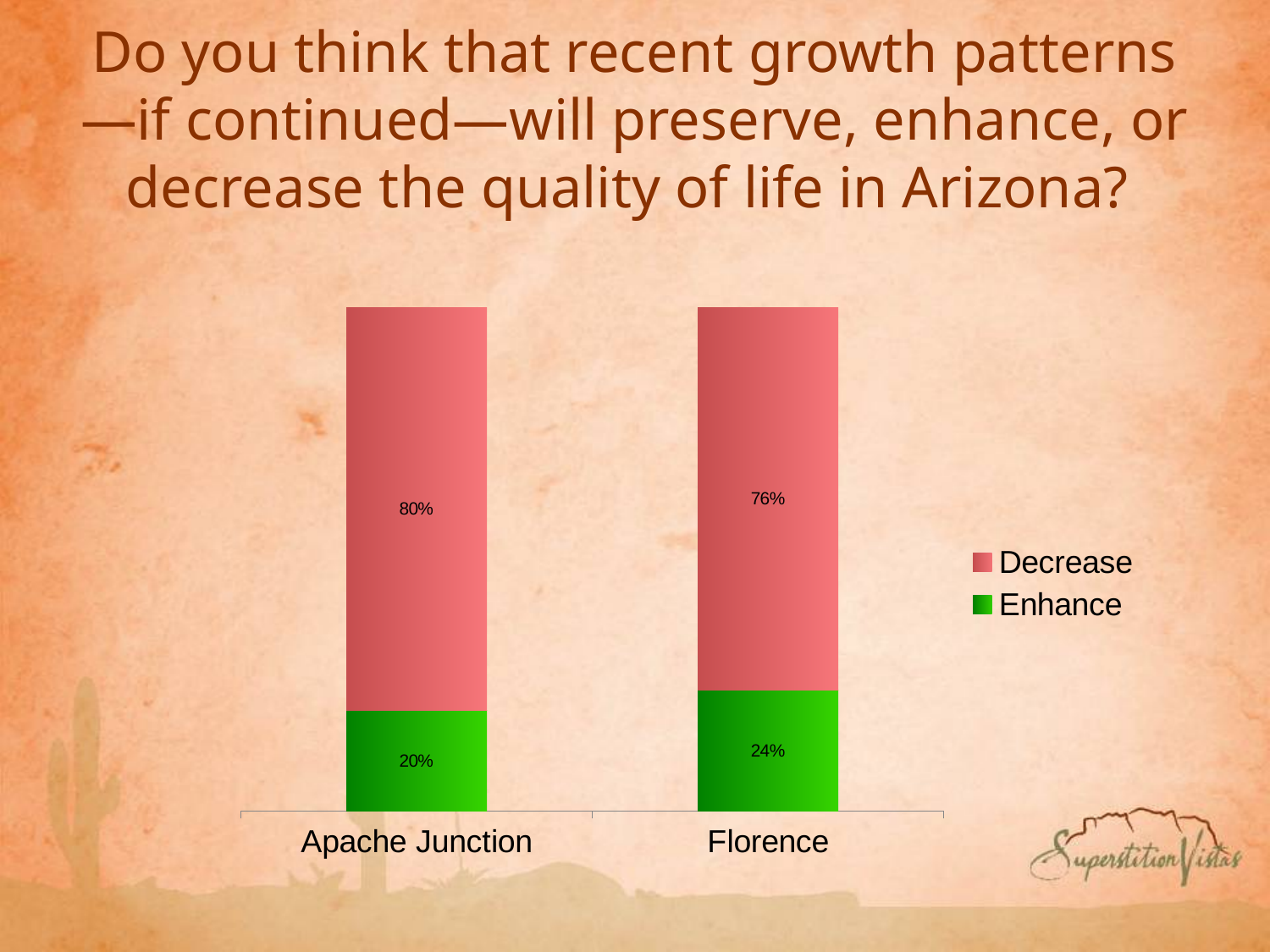
How many series does the legend list? 2 How many locations are shown on the x axis? 2 Is the Enhance value larger for Florence or Apache Junction? Florence What percentage of Apache Junction respondents said growth patterns will decrease quality of life? 80% Which location has the higher Decrease percentage? Apache Junction What is the difference between the Decrease values for Apache Junction and Florence? 4% What percentage of Florence respondents said growth patterns will enhance quality of life? 24% What is the Enhance value for Apache Junction? 20% What is the Decrease value for Florence? 76% What is the total of the stacked bar for Florence? 100% Which location has the lower Enhance percentage? Apache Junction What kind of chart is shown on the slide? Stacked bar chart